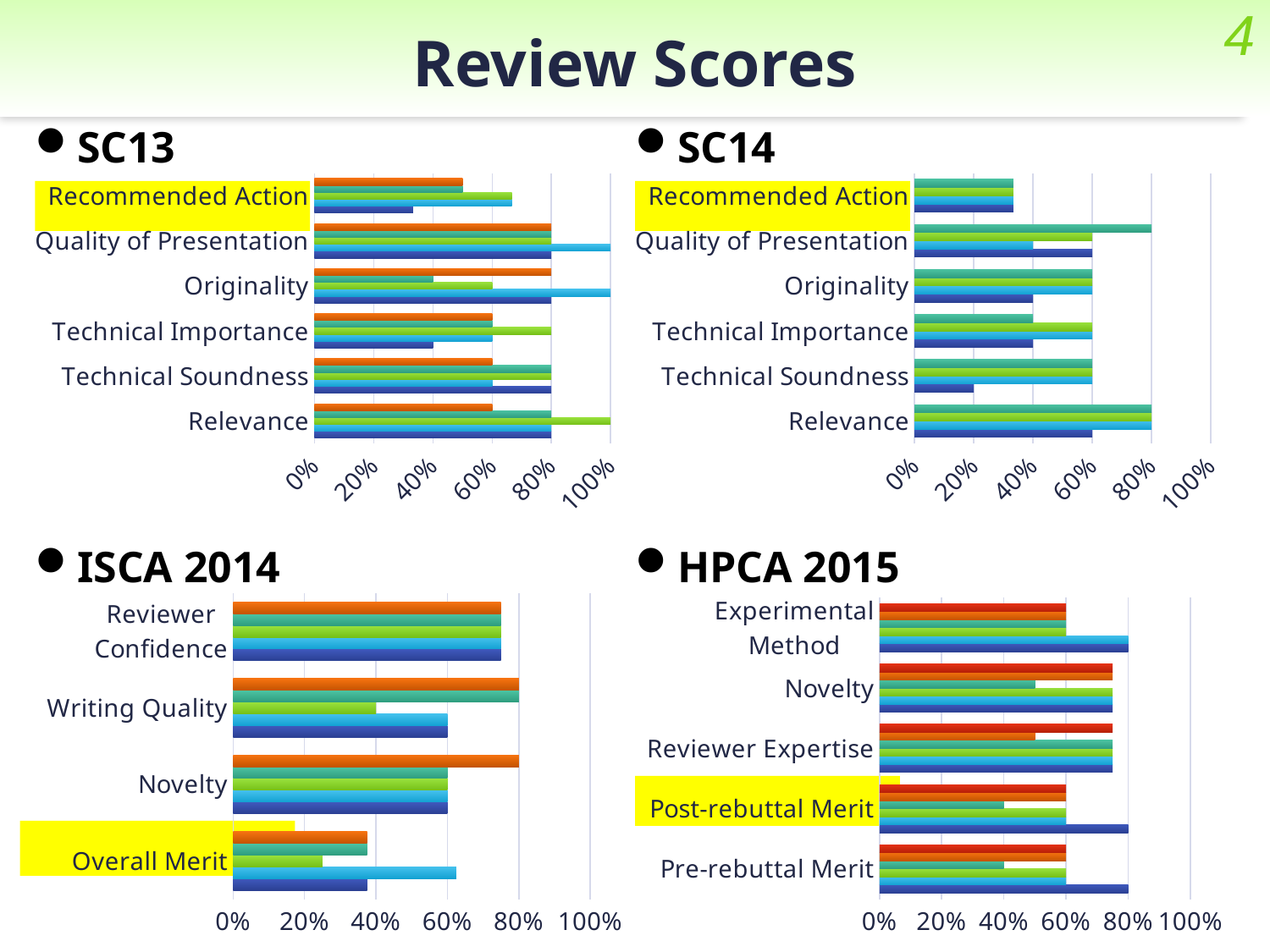
How many categories are shown on the SC14 chart? 6 What kind of chart is the SC13 chart? bar chart How many categories are shown on the ISCA 2014 chart? 4 How many categories are shown on the SC13 chart? 6 In the SC13 chart, is the longest bar for Recommended Action greater or less than 80%? less In the ISCA 2014 chart, is the shortest bar for Overall Merit greater or less than 40%? less In the HPCA 2015 chart, is the longest bar for Experimental Method greater or less than 60%? greater Which category label is highlighted in yellow on the ISCA 2014 chart? Overall Merit